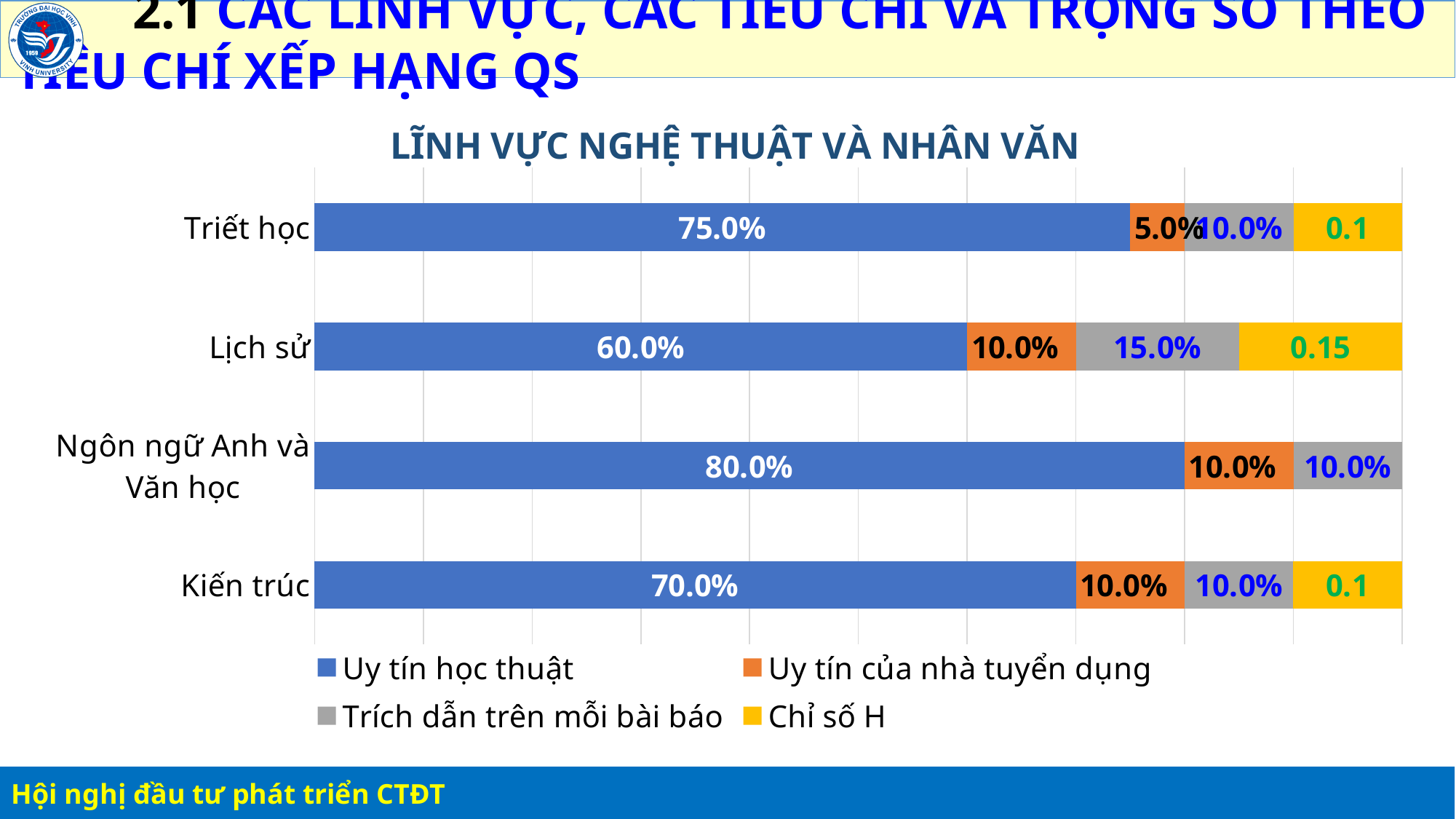
What is the value of Uy tín của nhà tuyển dụng for Triết học? 5.0% What is the difference between the Uy tín học thuật values for Ngôn ngữ Anh và Văn học and Lịch sử? 20.0% What is the value of Trích dẫn trên mỗi bài báo for Lịch sử? 15.0% Which category has the lowest value for Uy tín học thuật? Lịch sử How many series does the legend list? 4 How many categories are shown on the chart? 4 What is the value of Chỉ số H for Lịch sử? 0.15 What is the title of the chart? LĨNH VỰC NGHỆ THUẬT VÀ NHÂN VĂN What type of chart is shown on the slide? Stacked bar chart Which is larger: the Uy tín học thuật value for Kiến trúc or for Triết học? Triết học Which category has the highest value for Uy tín học thuật? Ngôn ngữ Anh và Văn học What is the value of Uy tín học thuật for Triết học? 75.0%